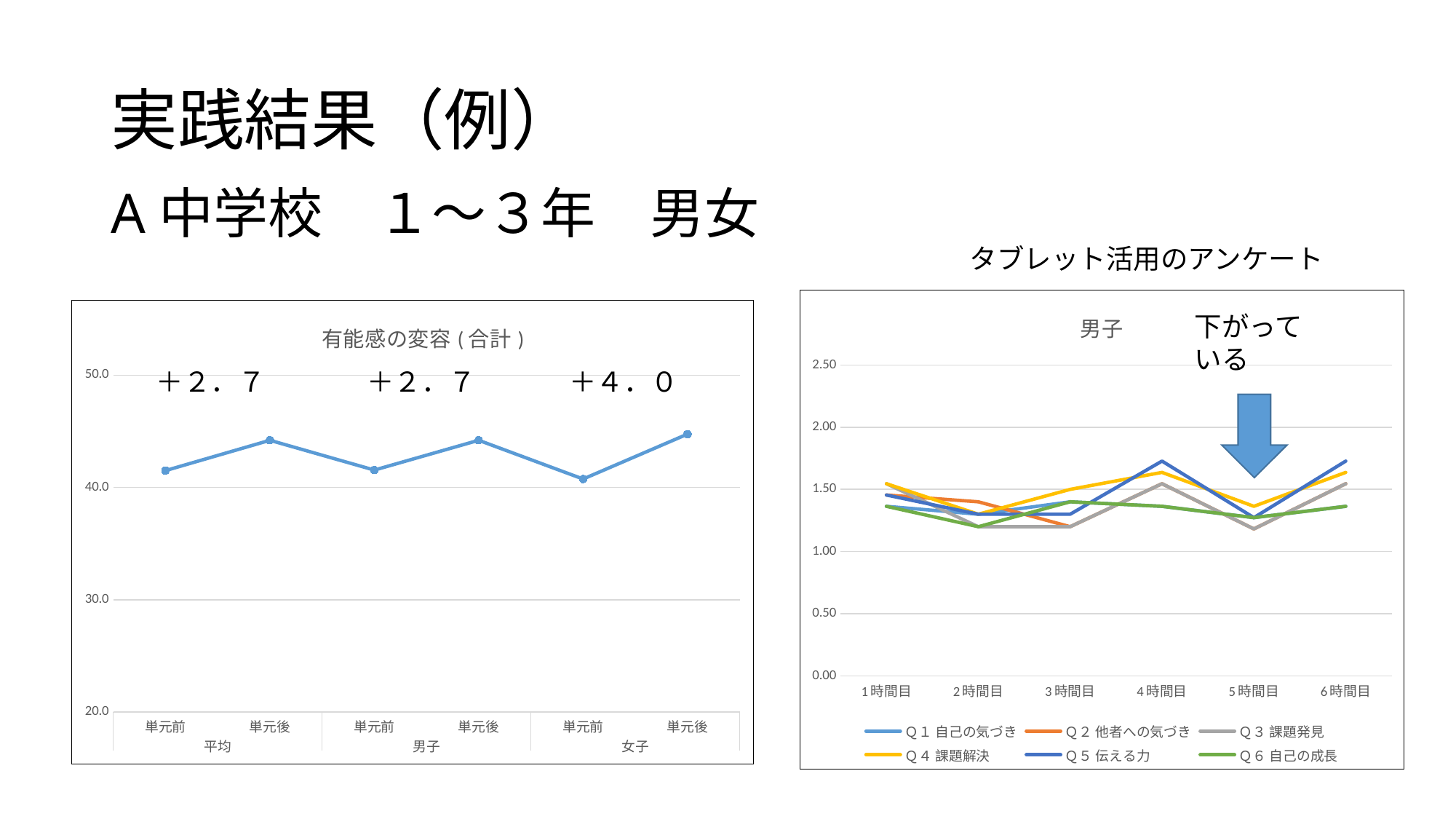
On the right chart titled 男子, is the value of Q5 伝える力 at 4時間目 greater or less than 1.50? greater On the left chart titled 有能感の変容(合計), is the value for 平均 単元前 greater or less than 40.0? greater On the left chart titled 有能感の変容(合計), which is larger for 女子: 単元前 or 単元後? 単元後 How many time-period categories are on the x axis of the right chart titled 男子? 6 On the left chart titled 有能感の変容(合計), what change is annotated above the 女子 pair of points? ＋4.0 What kind of chart is the left chart titled 有能感の変容(合計)? line chart How many series does the legend of the right chart titled 男子 list? 6 On the right chart titled 男子, which series is drawn in green according to the legend? Q6 自己の成長 On the left chart titled 有能感の変容(合計), is the value for 女子 単元後 greater or less than 50.0? less How many data points are plotted on the left chart titled 有能感の変容(合計)? 6 On the left chart titled 有能感の変容(合計), does the line rise or fall from 男子 単元前 to 男子 単元後? rise